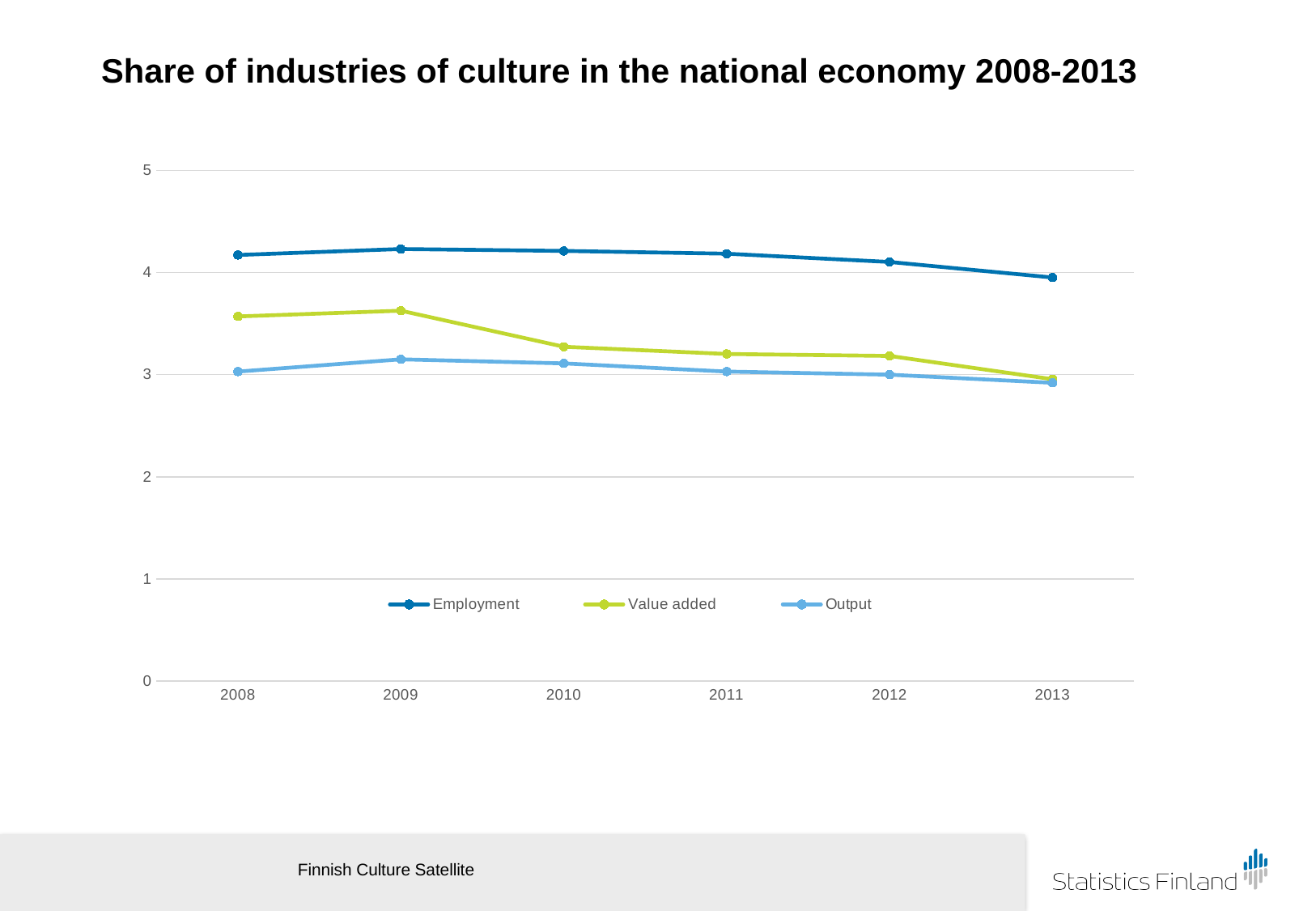
Is the value for Employment in 2012 greater or less than 4? greater What is the title of the chart? Share of industries of culture in the national economy 2008-2013 Which series has the highest values across all years? Employment Does the Employment series rise or fall from 2009 to 2013? fall In which year is the Value added series at its lowest? 2013 Is the value for Value added in 2010 greater or less than 3? greater In 2009, which is larger: Value added or Output? Value added How many series does the legend list? 3 Is the value for Employment in 2008 greater or less than 4? greater Which series has the lowest value in 2008? Output What kind of chart is shown on the slide? line chart How many years are shown on the x axis? 6